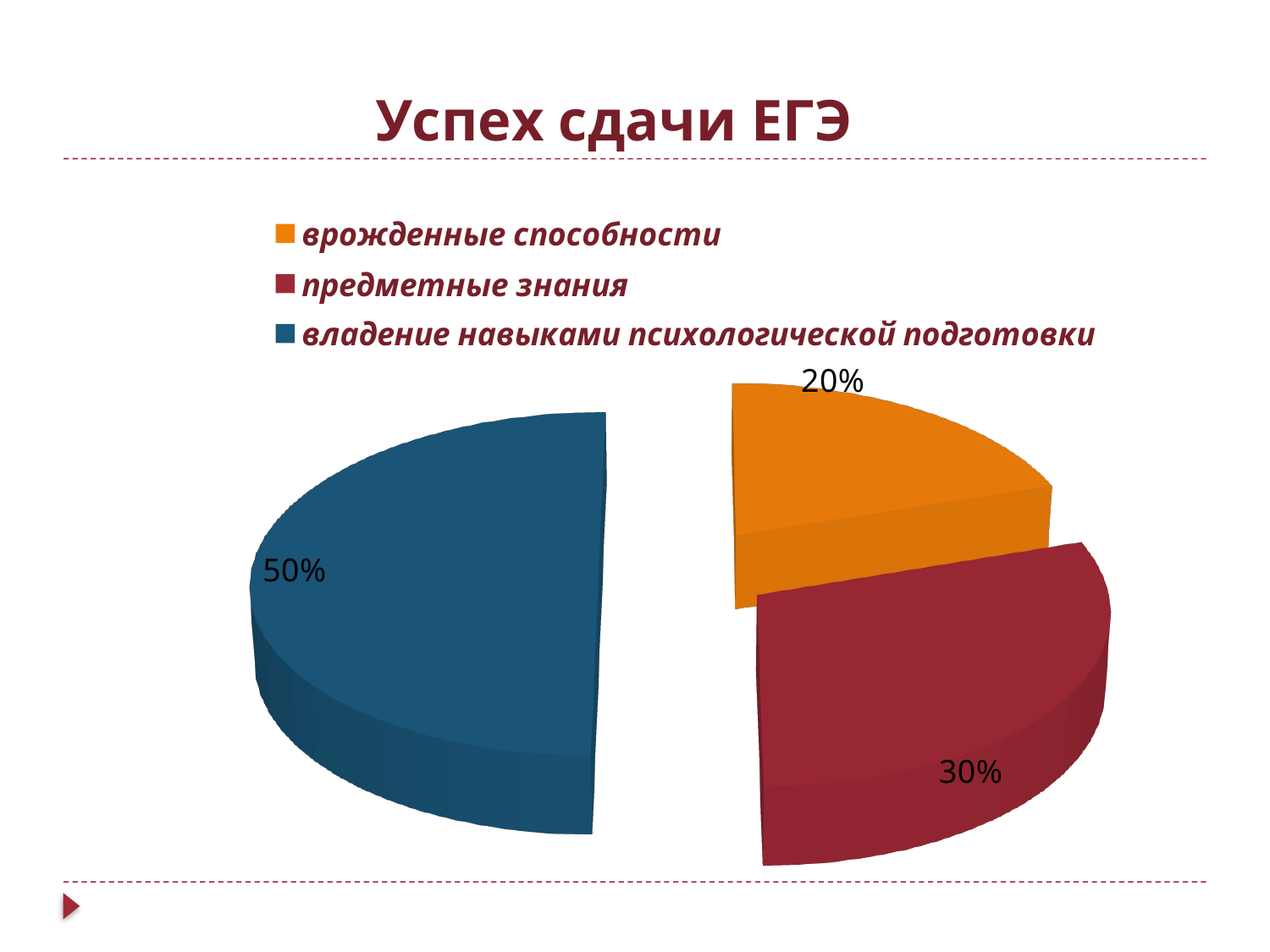
How many entries does the legend list? 3 What colour is the slice for 'предметные знания'? red What kind of chart is shown on the slide? pie chart Which category has the largest slice of the pie? владение навыками психологической подготовки Which is larger: the slice for 'предметные знания' or the slice for 'врожденные способности'? предметные знания What is the difference in percentage points between 'владение навыками психологической подготовки' and 'предметные знания'? 20 How many slices does the pie chart have? 3 Which category has the smallest slice of the pie? врожденные способности What share of the pie does 'владение навыками психологической подготовки' have? 50% What share of the pie does 'предметные знания' have? 30% What is the title of the slide? Успех сдачи ЕГЭ What share of the pie does 'врожденные способности' have? 20%